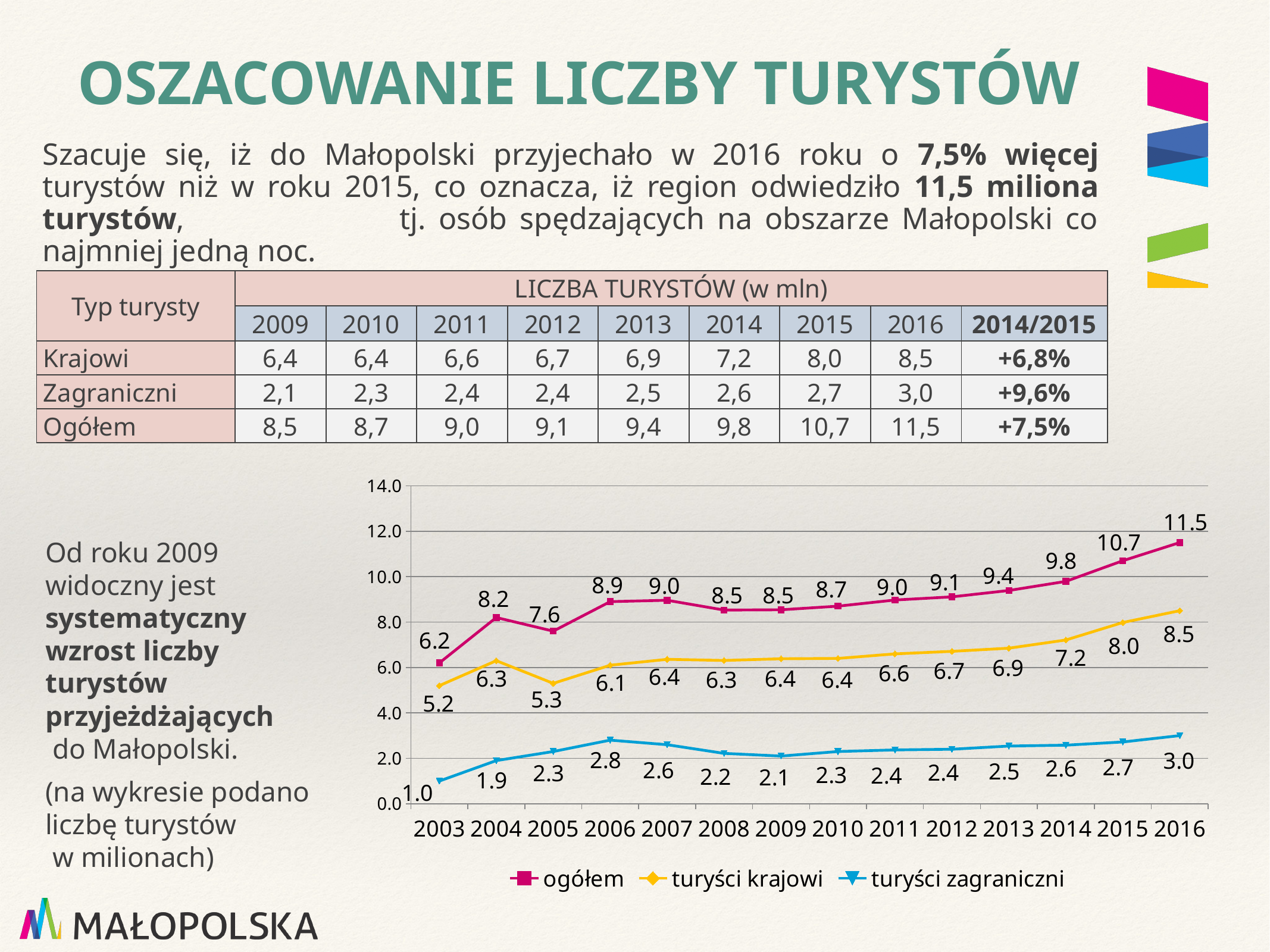
In which year does the 'ogółem' series reach its highest value? 2016 How many years are plotted along the x axis of the chart? 14 Which is larger: the 'turyści zagraniczni' value in 2006 or in 2009? 2006 What is the value of the 'turyści krajowi' series in 2015? 8.0 What type of chart is shown on the slide? line chart How many series does the chart legend list? 3 In which year does the 'turyści krajowi' series have its lowest value? 2003 What is the difference between the 'ogółem' values for 2016 and 2015? 0.8 Which series in the chart is drawn in blue? turyści zagraniczni What is the value of the 'turyści zagraniczni' series in 2003? 1.0 What is the value of the 'ogółem' series in 2016? 11.5 Does the 'ogółem' series generally rise or fall between 2009 and 2016? rise